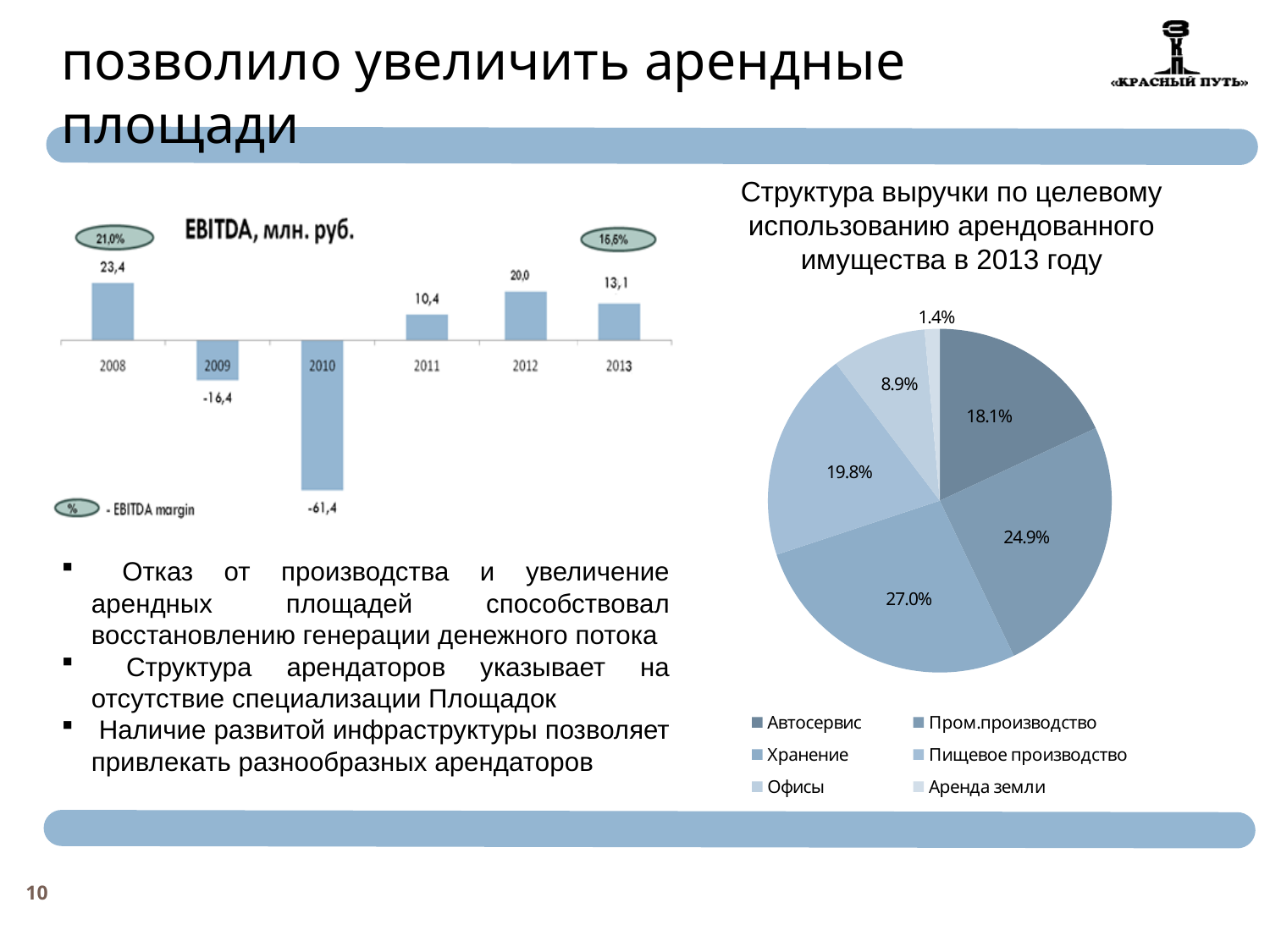
In the pie chart on the right, what share does Аренда земли have? 1.4% In the EBITDA, млн. руб. chart, which year has the highest value? 2008 In the EBITDA, млн. руб. chart, what is the difference between the values for 2012 and 2011? 9,6 In the EBITDA, млн. руб. chart, what is the value for 2013? 13,1 In the EBITDA, млн. руб. chart, how many years are shown? 6 How many categories does the legend of the pie chart on the right list? 6 In the pie chart on the right, which category has the largest share? Хранение In the pie chart on the right (Структура выручки по целевому использованию арендованного имущества в 2013 году), what share does Хранение have? 27.0% In the EBITDA, млн. руб. chart, what is the value for 2010? -61,4 What kind of chart is the EBITDA, млн. руб. chart? bar chart In the EBITDA, млн. руб. chart, what is the value for 2008? 23,4 In the EBITDA, млн. руб. chart, which year has the lowest value? 2010